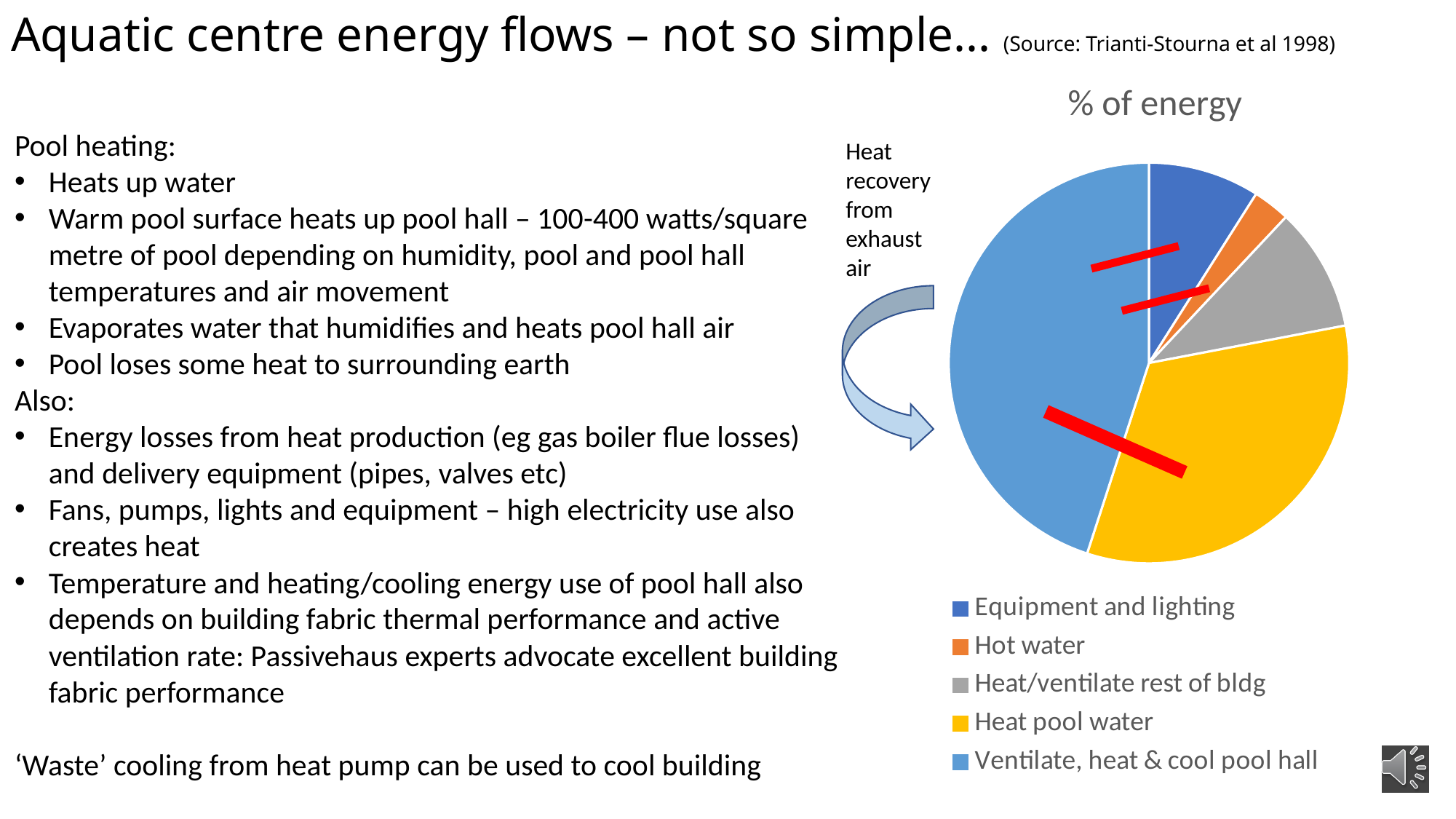
What colour is the Heat pool water slice in the pie chart? yellow How many categories does the pie chart show? 5 Which is larger in the pie chart: Heat pool water or Hot water? Heat pool water Which category has the largest slice of the pie chart? Ventilate, heat & cool pool hall What kind of chart is shown on the slide? pie chart Which is larger in the pie chart: Equipment and lighting or Heat pool water? Heat pool water What is the title of the pie chart? % of energy Which is larger in the pie chart: Heat/ventilate rest of bldg or Hot water? Heat/ventilate rest of bldg Which category has the smallest slice of the pie chart? Hot water